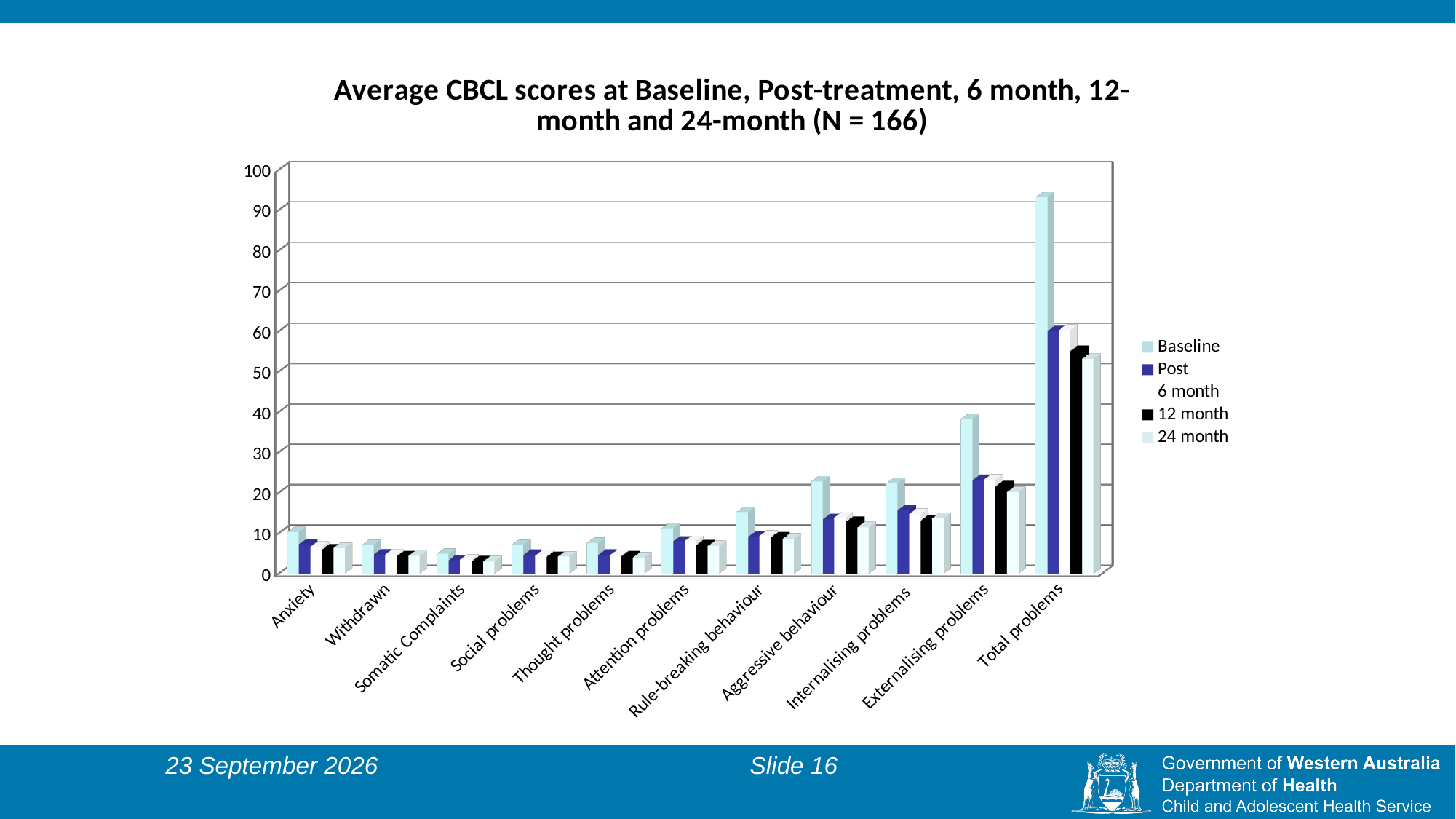
Which is larger, the Baseline value for Externalising problems or the Baseline value for Internalising problems? Externalising problems For Total problems, which is larger, the Baseline value or the Post value? Baseline Which category has the lowest Baseline value? Somatic Complaints How many series does the legend list? 5 Is the Baseline value for Anxiety greater or less than 20? less What kind of chart is shown on the slide? bar chart How many categories are shown on the x axis of the chart? 11 Is the Baseline value for Total problems greater or less than 80? greater Is the Post value for Total problems greater or less than 50? greater Which category has the highest Baseline value? Total problems What is the title of the chart? Average CBCL scores at Baseline, Post-treatment, 6 month, 12-month and 24-month (N = 166)